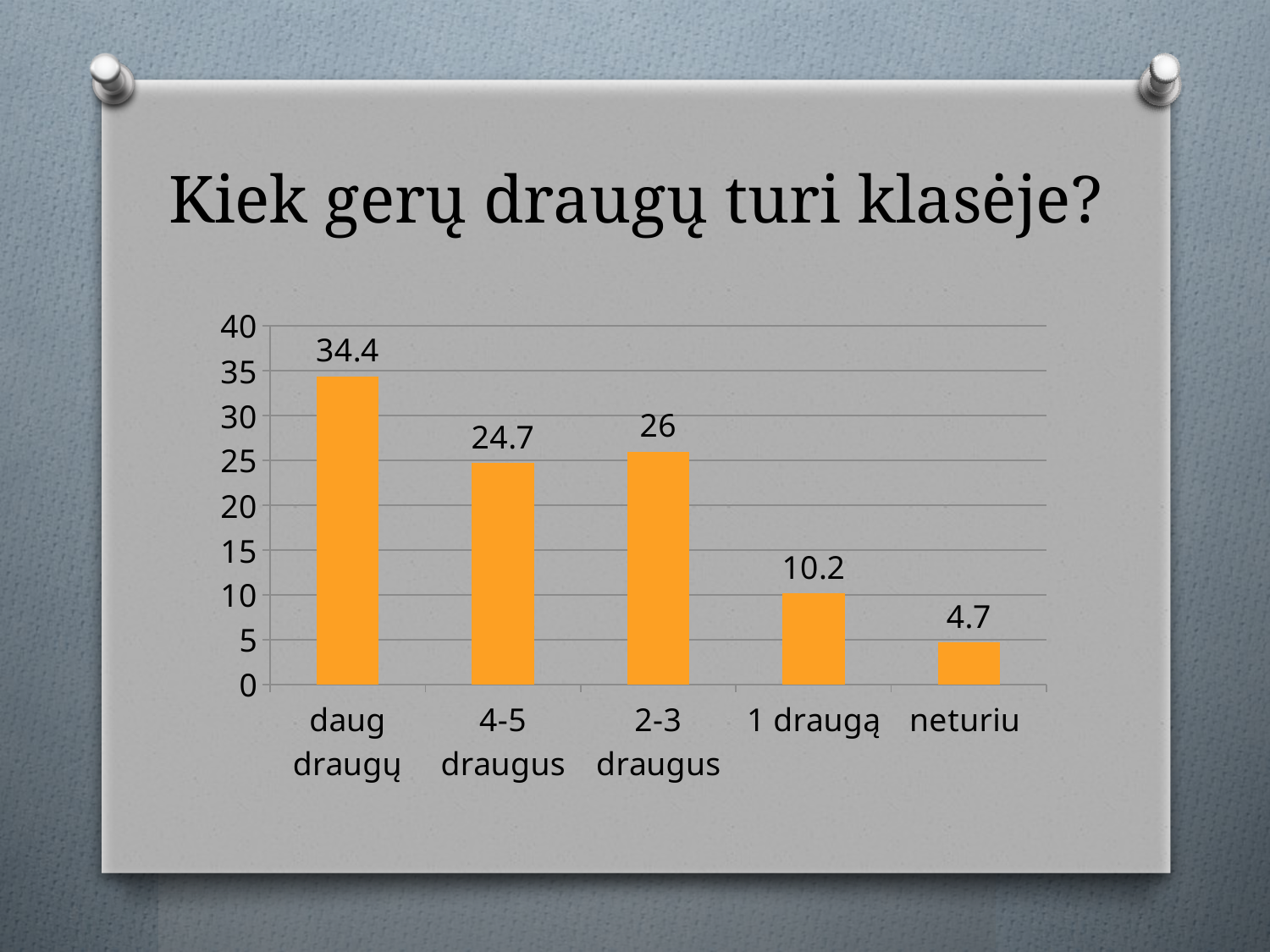
Is the value for "1 draugą" greater or less than 15? less Which category has the highest value? daug draugų Which is larger, the value for "2-3 draugus" or "4-5 draugus"? 2-3 draugus Which category has the lowest value? neturiu How many categories are shown on the x axis? 5 What is the title of the slide? Kiek gerų draugų turi klasėje? What is the value for "daug draugų"? 34.4 What is the value for "1 draugą"? 10.2 What kind of chart is shown on the slide? bar chart What is the value for "4-5 draugus"? 24.7 What is the value for "neturiu"? 4.7 What is the difference between the values for "daug draugų" and "2-3 draugus"? 8.4